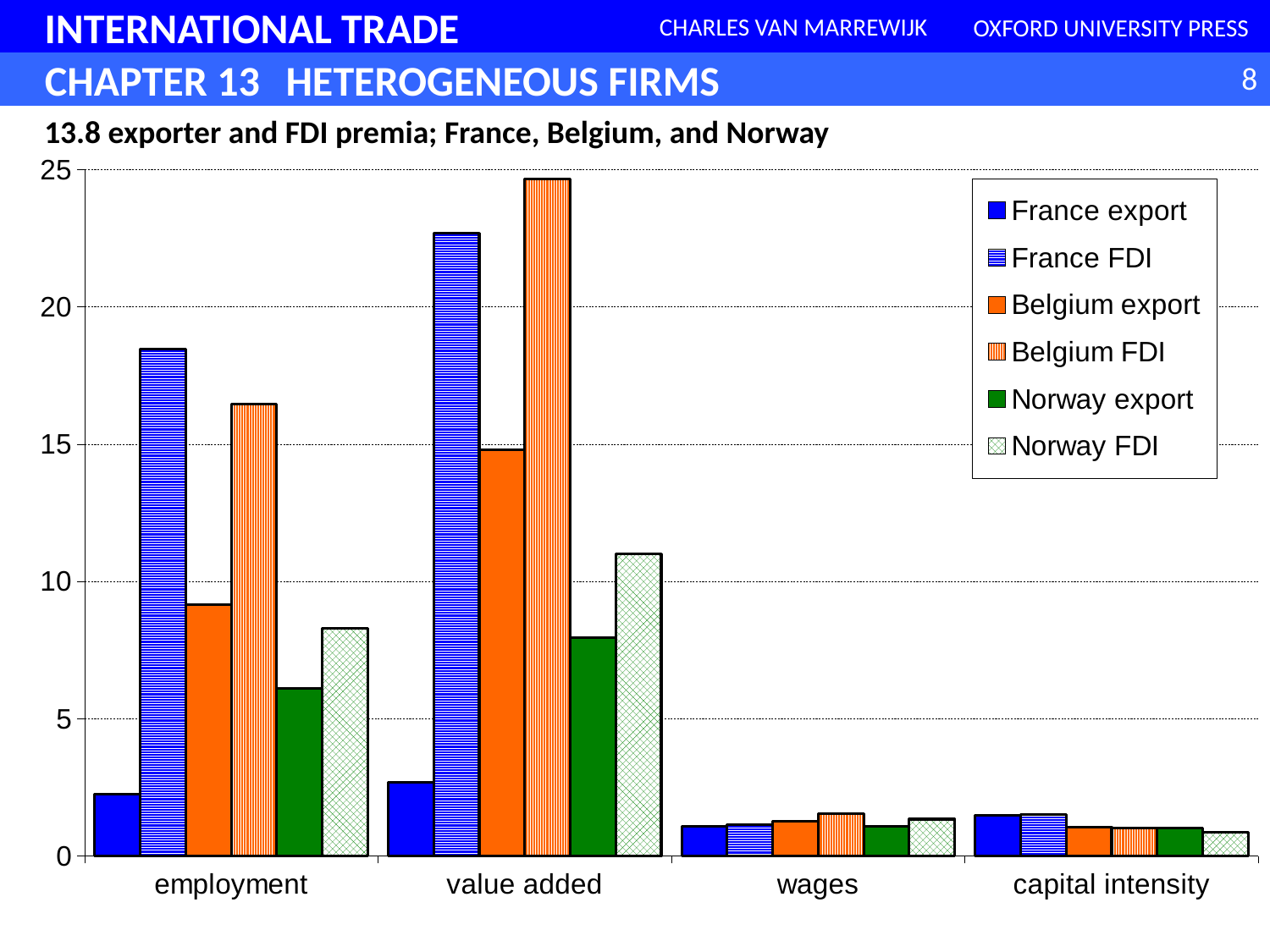
Is the value for Belgium export in the employment category greater or less than 10? less Which series has the lowest bar in the employment category? France export In the employment category, which is larger: France FDI or Belgium FDI? France FDI What is the title of the chart? 13.8 exporter and FDI premia; France, Belgium, and Norway How many categories are shown on the x axis? 4 Is the value for Norway FDI in the value added category greater or less than 10? greater In which category is the Belgium FDI bar the tallest? value added What kind of chart is shown on the slide? bar chart How many series does the legend list? 6 In the value added category, which is larger: Belgium FDI or France FDI? Belgium FDI Is the value for Norway export in the value added category greater or less than 10? less